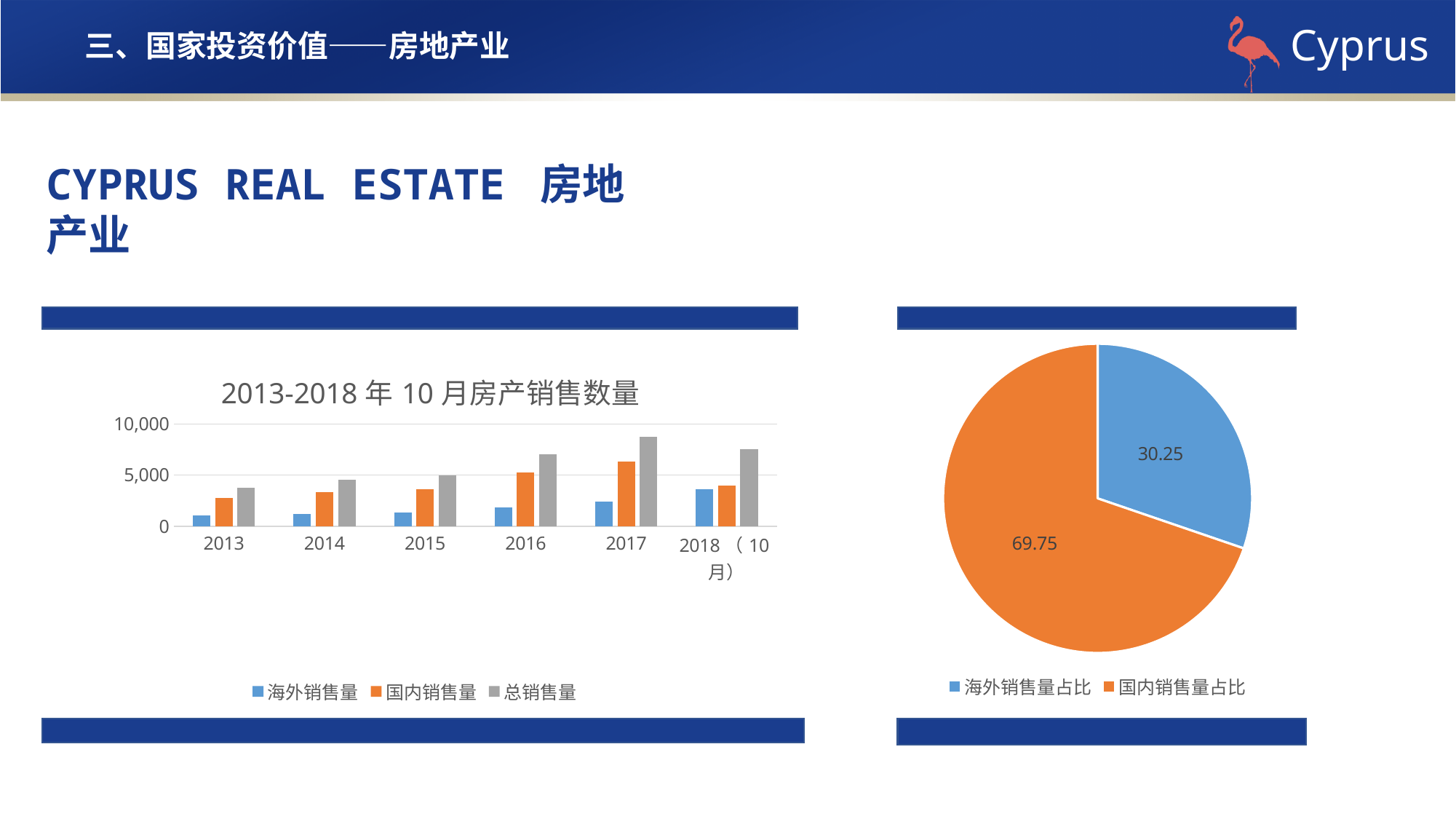
What kind of chart is the chart titled 2013-2018 年 10 月房产销售数量? bar chart In the chart titled 2013-2018 年 10 月房产销售数量, is the 总销售量 for 2017 greater or less than 5,000? greater In the pie chart on the right, what is the value shown for 海外销售量占比? 30.25 In the chart titled 2013-2018 年 10 月房产销售数量, how many series does the legend list? 3 In the chart titled 2013-2018 年 10 月房产销售数量, how many year categories are shown on the x axis? 6 What kind of chart is the chart on the right of the slide? pie chart In the chart titled 2013-2018 年 10 月房产销售数量, does the 总销售量 rise or fall from 2013 to 2017? rise In the pie chart on the right, which slice is the largest? 国内销售量占比 In the chart titled 2013-2018 年 10 月房产销售数量, is the 海外销售量 for 2014 greater or less than 5,000? less In the chart titled 2013-2018 年 10 月房产销售数量, which is larger in 2016, 国内销售量 or 海外销售量? 国内销售量 In the chart titled 2013-2018 年 10 月房产销售数量, which year has the highest 总销售量? 2017 In the chart titled 2013-2018 年 10 月房产销售数量, which year has the lowest 海外销售量? 2013